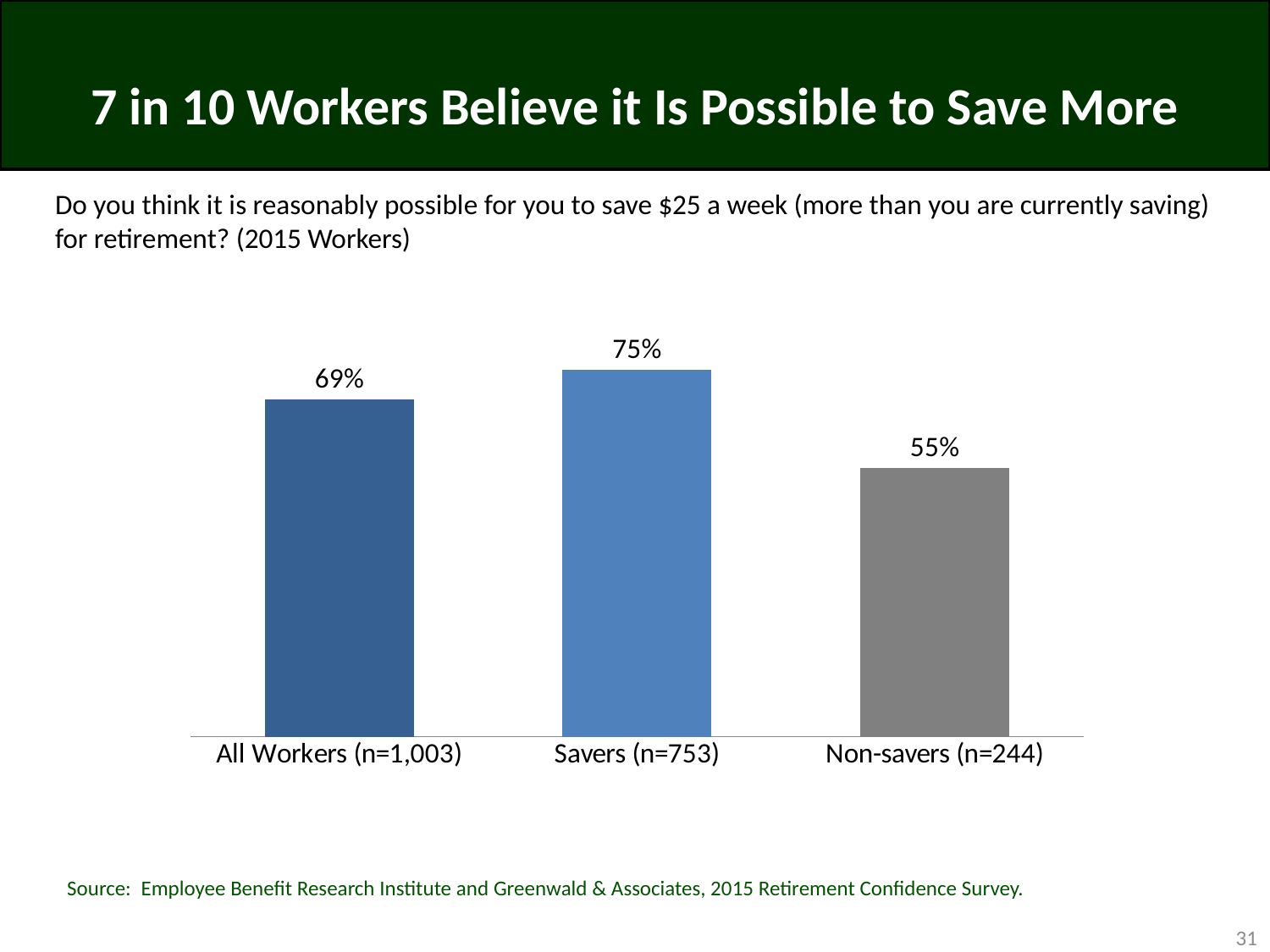
Which category has the highest value in the chart? Savers (n=753) How many categories are shown in the chart? 3 What percentage of All Workers (n=1,003) think it is reasonably possible to save $25 a week more for retirement? 69% What kind of chart is shown on the slide? Bar chart What is the title of the slide containing the chart? 7 in 10 Workers Believe it Is Possible to Save More What colour is the bar for Non-savers (n=244)? Gray What is the value shown for Non-savers (n=244)? 55% What is the difference between the values for Savers (n=753) and Non-savers (n=244)? 20% What is the value shown for Savers (n=753)? 75% Which is larger, the value for All Workers (n=1,003) or the value for Non-savers (n=244)? All Workers (n=1,003) Which category has the lowest value in the chart? Non-savers (n=244) What is the difference between the values for Savers (n=753) and All Workers (n=1,003)? 6%